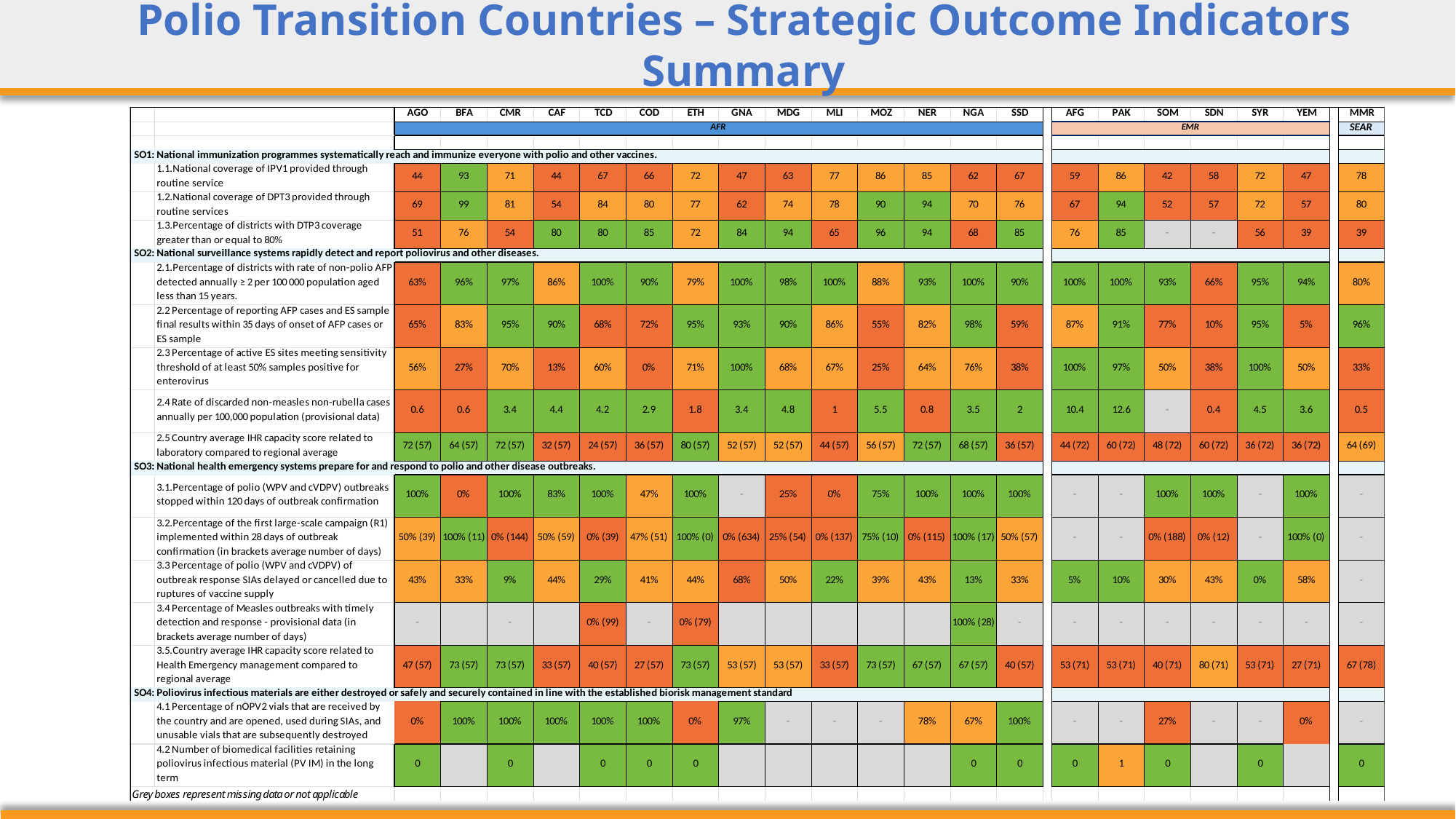
According to the note on the slide, what do grey boxes represent? Missing data or not applicable What is the percentage of districts with rate of non-polio AFP detected annually ≥ 2 per 100 000 population for SDN? 66% Which country has the lowest national coverage of IPV1 provided through routine service? SOM What is the difference in DPT3 coverage between BFA and SOM? 47 Which country has the highest rate of discarded non-measles non-rubella cases annually per 100,000 population? PAK What is the national coverage of IPV1 provided through routine service for BFA? 93 What is the national coverage of DPT3 provided through routine services for PAK? 94 How many countries are listed under the EMR region? 6 How many countries are listed under the AFR region? 14 Which country has the highest national coverage of DPT3 provided through routine services? BFA Which has the higher IPV1 coverage, MOZ or AGO? MOZ What is the rate of discarded non-measles non-rubella cases annually per 100,000 population for PAK? 12.6